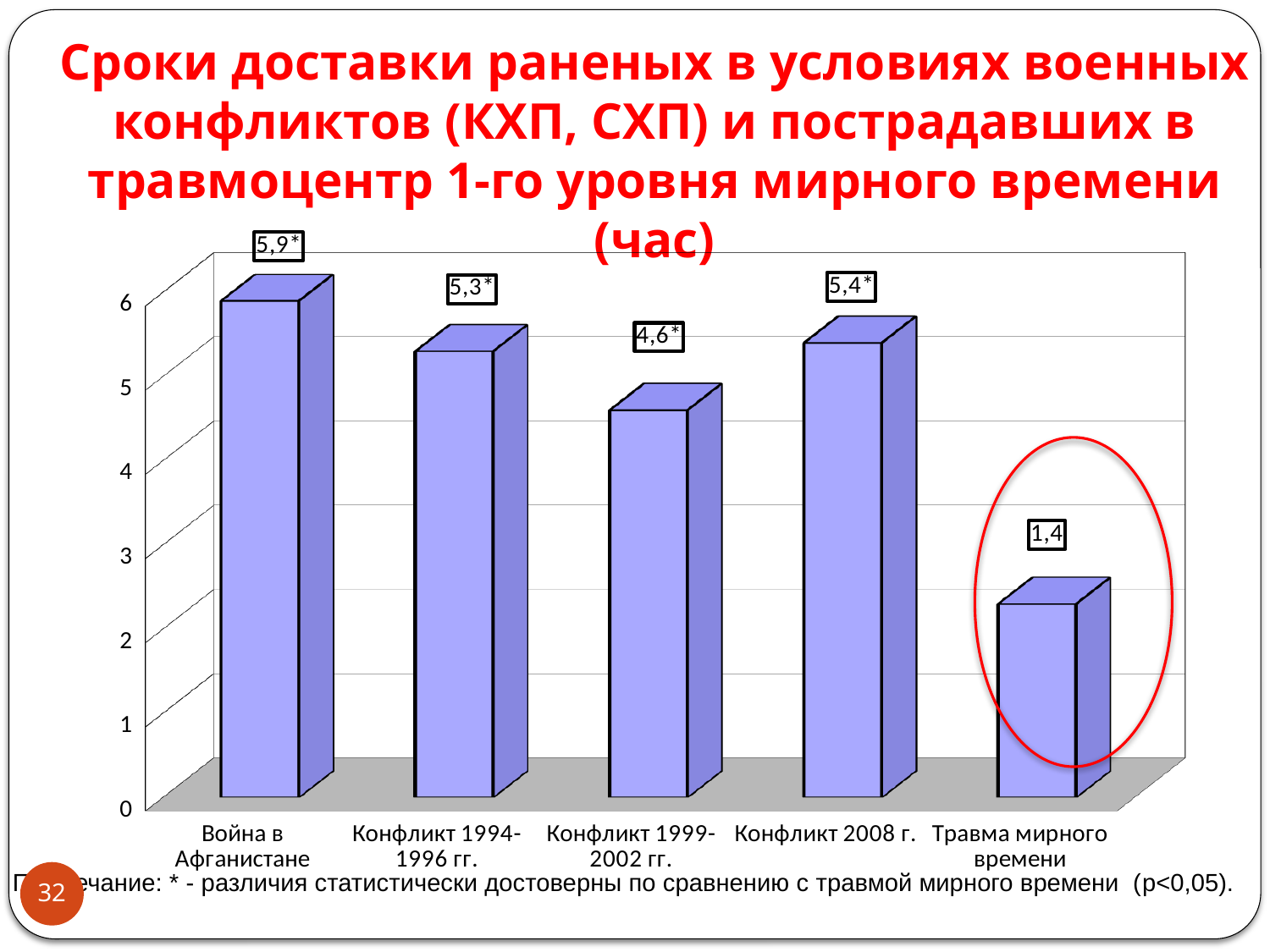
What is the value shown for Конфликт 1999-2002 гг.? 4,6* What is the value shown for Конфликт 2008 г.? 5,4* Is the value for Конфликт 1999-2002 гг. greater or less than 5? less What is the value shown for Травма мирного времени? 1,4 What kind of chart is shown on the slide? bar chart What is the difference between the values for Война в Афганистане and Травма мирного времени? 4,5 Which is larger: the value for Конфликт 1994-1996 гг. or the value for Конфликт 2008 г.? Конфликт 2008 г. Which category has the highest value? Война в Афганистане What is the difference between the values for Война в Афганистане and Конфликт 1999-2002 гг.? 1,3 How many categories are shown on the chart? 5 Which category has the lowest value? Травма мирного времени What is the value shown for Война в Афганистане? 5,9*